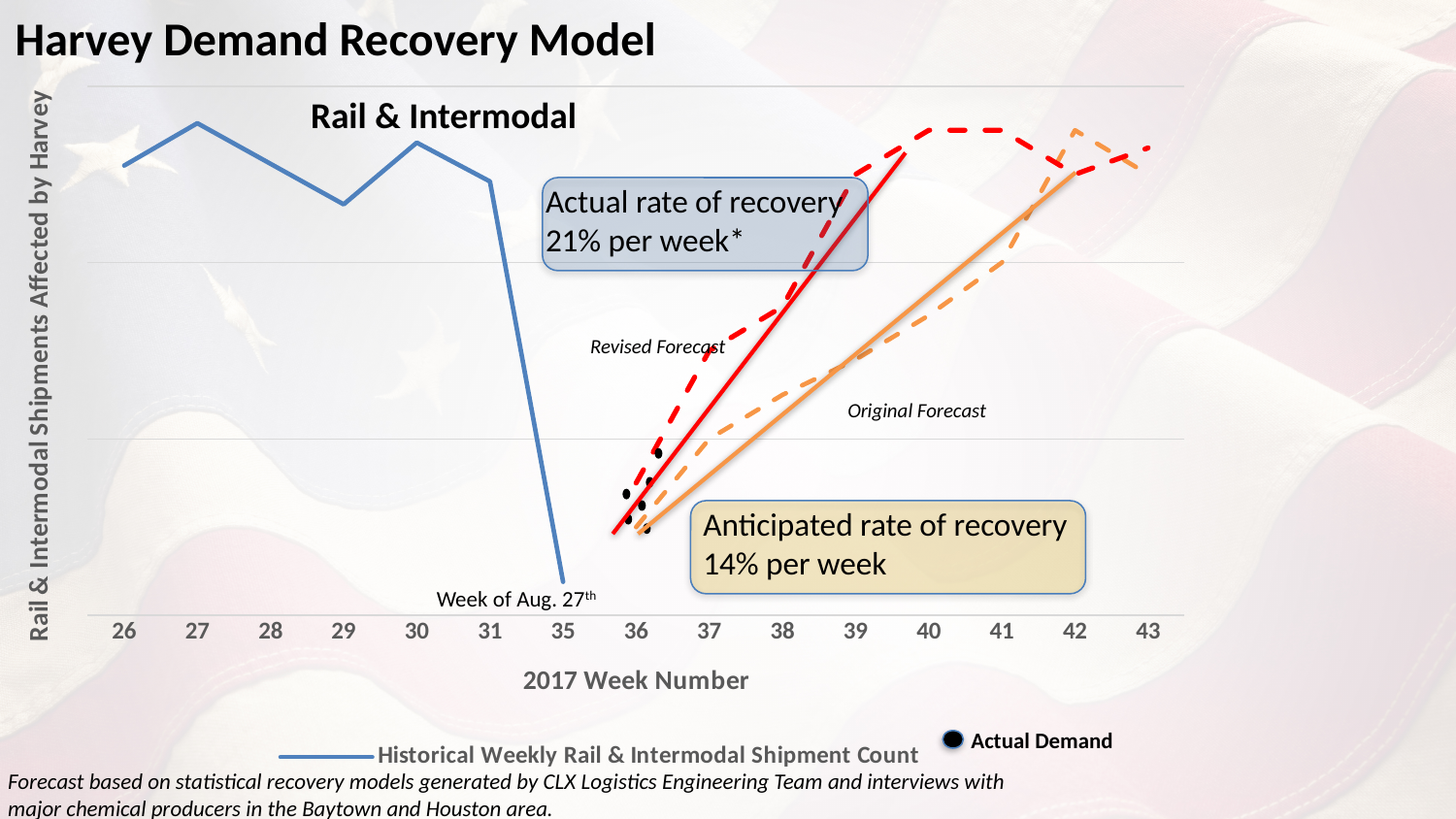
At which week number does the historical shipment line reach its lowest point? 35 How many week numbers are labeled on the x axis of the chart? 15 Is the historical shipment count higher at week 27 or at week 29? week 27 Does the historical shipment line rise or fall between week 31 and week 35? fall Is the historical shipment count higher at week 30 or at week 31? week 30 What actual rate of recovery per week is stated on the chart? 21% per week Does the Revised Forecast line rise or fall from week 36 to week 40? rise What kind of chart is shown on the slide? line chart What anticipated rate of recovery per week is stated on the chart? 14% per week What legend label is given to the blue line? Historical Weekly Rail & Intermodal Shipment Count What is the title of the x axis? 2017 Week Number At which week number does the historical shipment line reach its highest point? 27